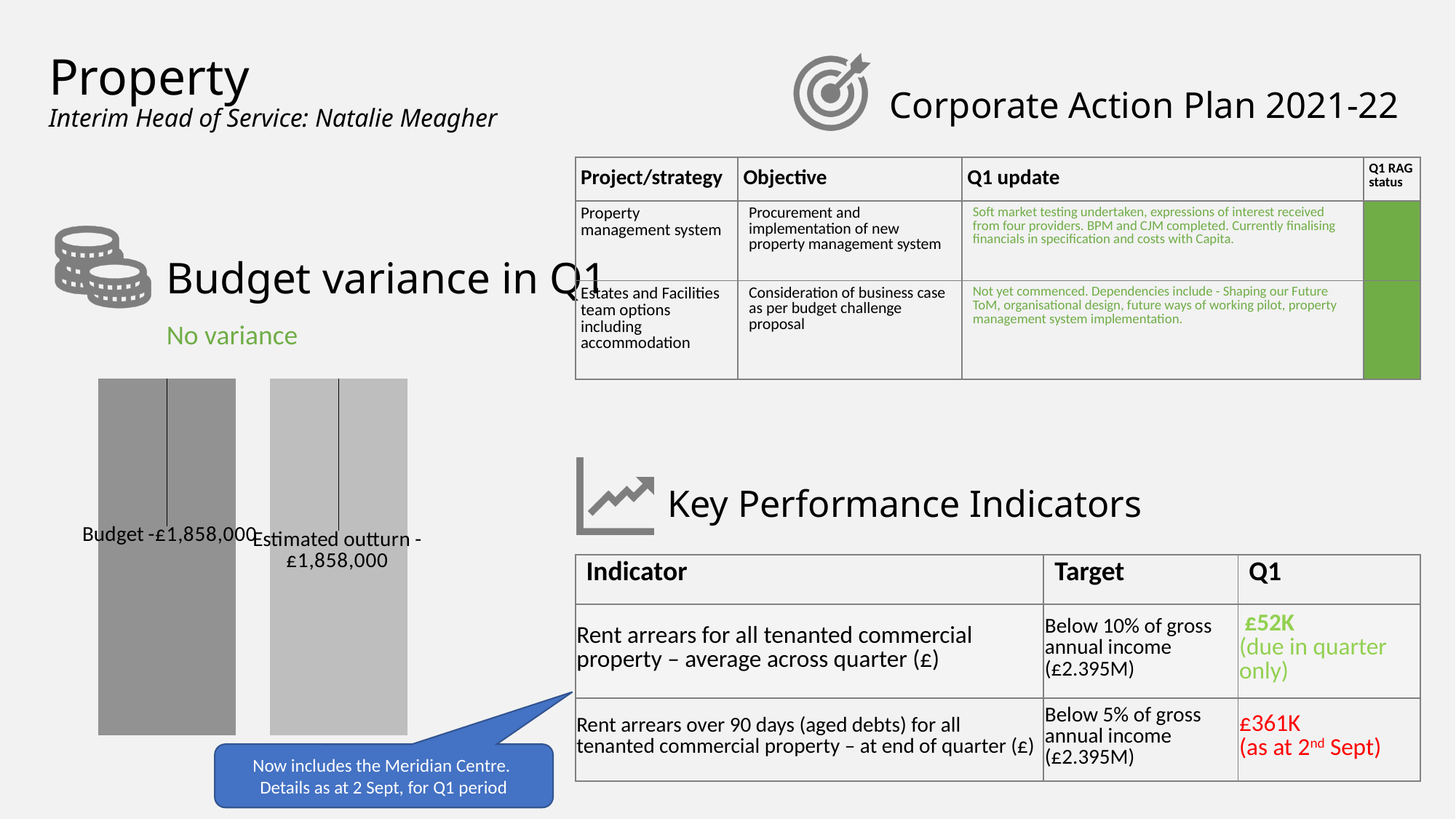
What is the title of the chart on the left of the slide? Budget variance in Q1 What is the difference between the Budget and Estimated outturn values in the Budget variance in Q1 chart? £0 How many bars are plotted in the Budget variance in Q1 chart? 2 What does the green text above the Budget variance in Q1 chart say? No variance What is the value of the Estimated outturn bar in the Budget variance in Q1 chart? £1,858,000 Is the Budget value in the Budget variance in Q1 chart equal to the Estimated outturn value? Yes What are the two categories shown in the Budget variance in Q1 chart? Budget and Estimated outturn What is the value of the Budget bar in the Budget variance in Q1 chart? £1,858,000 What kind of chart is used to show the budget variance in Q1? Bar chart